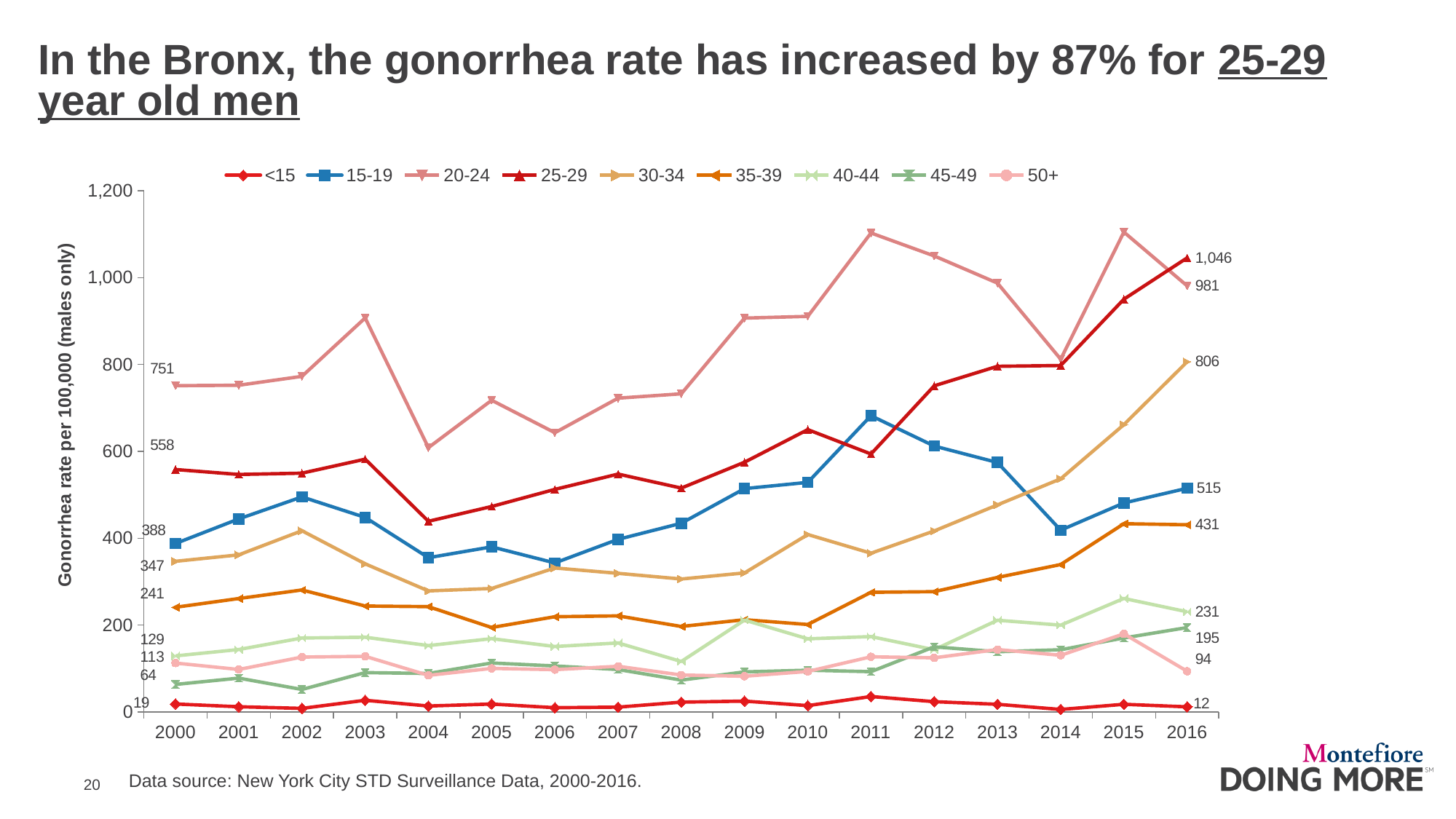
What is the gonorrhea rate for 25-29 year old men in 2016? 1,046 What kind of chart is shown on the slide? line chart Which age group has the lowest gonorrhea rate in 2016? <15 Is the value for the 20-24 age group in 2011 greater or less than 1,000? greater By how much did the rate for the 25-29 age group increase from 2000 to 2016? 488 What is the value for the 30-34 age group in 2016? 806 What is the gonorrhea rate for the 20-24 age group in 2000? 751 What is the value for the 45-49 age group in 2000? 64 How many years are shown on the x axis? 17 Which age group has the highest gonorrhea rate in 2016? 25-29 In 2016, which is higher: the rate for 15-19 or the rate for 35-39? 15-19 How many age groups does the legend list? 9